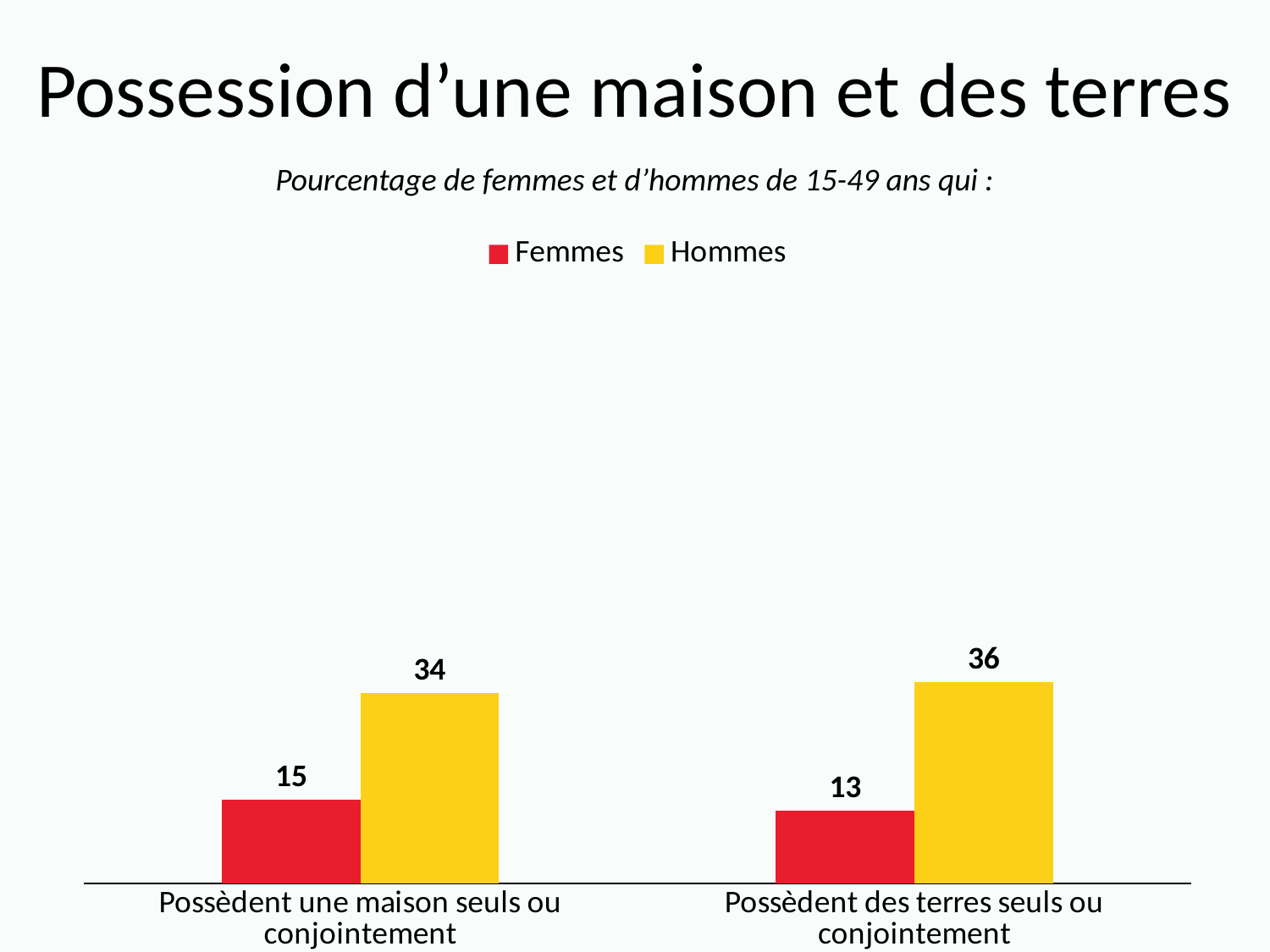
Which bar has the lowest value in the chart? Femmes, Possèdent des terres seuls ou conjointement What is the difference between the Hommes and Femmes values for "Possèdent des terres seuls ou conjointement"? 23 Which series has the highest value in the chart? Hommes How many categories are shown on the x axis? 2 What is the value for Hommes in the category "Possèdent une maison seuls ou conjointement"? 34 What is the value for Femmes in the category "Possèdent une maison seuls ou conjointement"? 15 How many series does the legend list? 2 What kind of chart is shown on the slide? Bar chart Which is larger: the Femmes value for owning a house or the Femmes value for owning land? Owning a house (15) What is the value for Hommes in the category "Possèdent des terres seuls ou conjointement"? 36 What is the value for Femmes in the category "Possèdent des terres seuls ou conjointement"? 13 What is the difference between the Hommes and Femmes values for "Possèdent une maison seuls ou conjointement"? 19